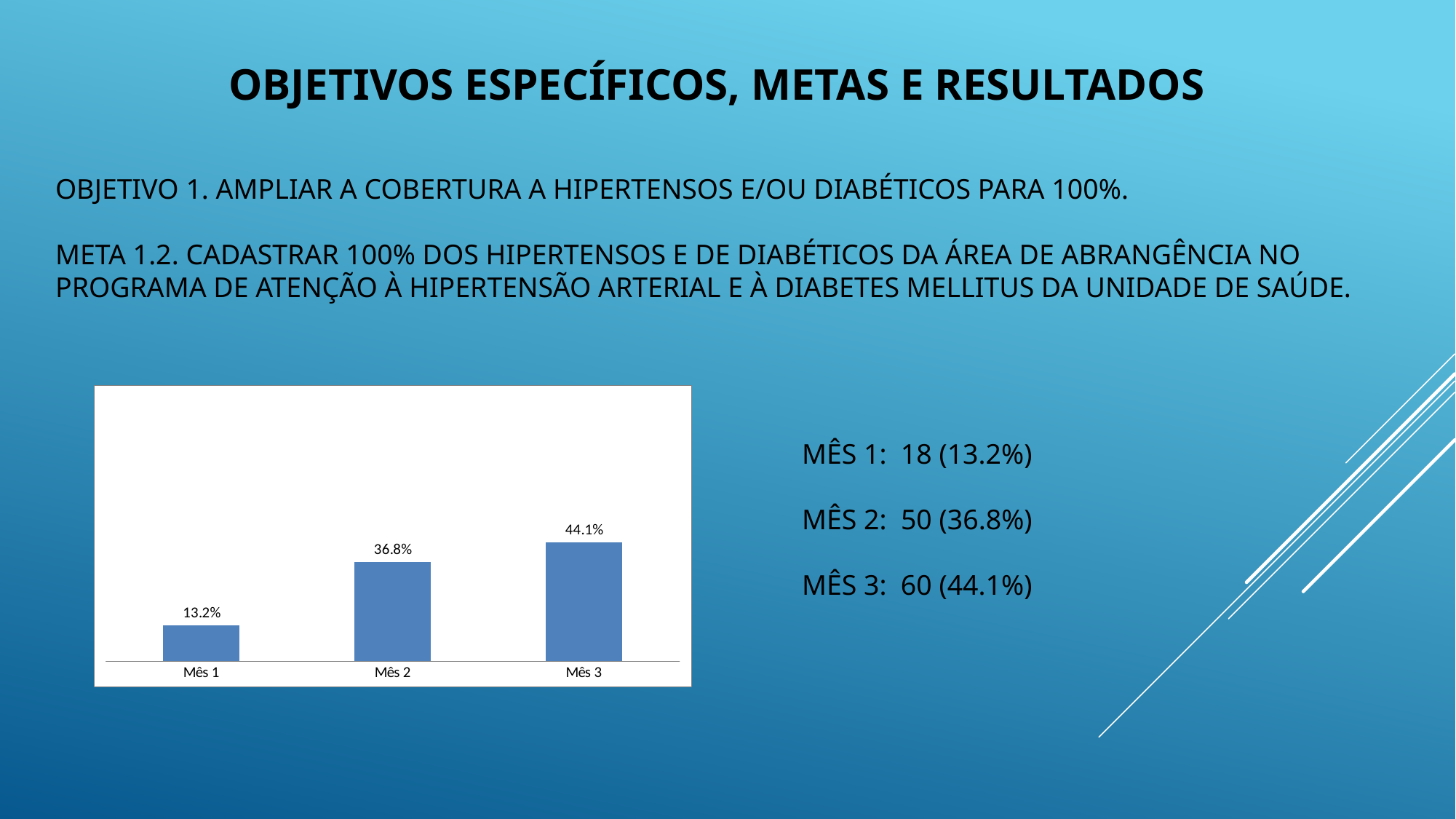
What is the difference between the values for Mês 3 and Mês 2? 7.3% Which is larger, the value for Mês 1 or the value for Mês 2? Mês 2 What is the difference between the values for Mês 2 and Mês 1? 23.6% What is the value shown for Mês 3 in the chart? 44.1% Do the values rise or fall from Mês 1 to Mês 3? Rise Which month has the lowest value in the chart? Mês 1 Which month has the highest value in the chart? Mês 3 What colour are the bars in the chart? Blue What kind of chart is shown on the slide? Bar chart What is the value shown for Mês 1 in the chart? 13.2% What is the value shown for Mês 2 in the chart? 36.8% How many categories are plotted in the chart? 3